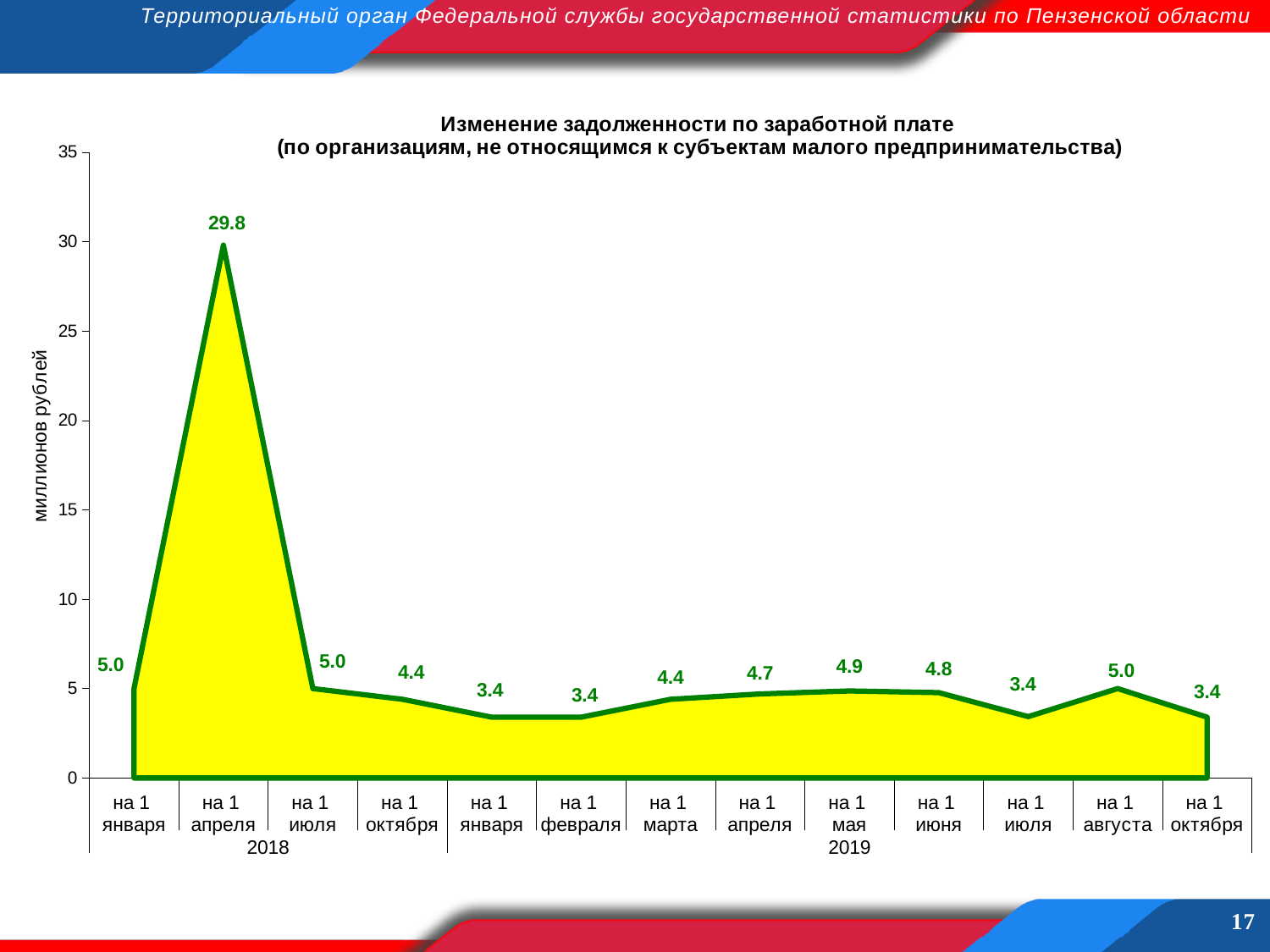
Is the value on 1 апреля 2018 greater or less than 25? greater What is the value shown for 1 октября 2019? 3.4 What is the value shown for 1 мая 2019? 4.9 Which is larger: the value on 1 апреля 2019 or on 1 июня 2019? на 1 июня 2019 What is the difference between the values on 1 апреля 2018 and 1 июля 2018? 24.8 What is the lowest value plotted on the chart? 3.4 Does the value rise or fall from 1 августа 2019 to 1 октября 2019? fall What is the wage arrears value on 1 апреля 2018? 29.8 What type of chart is shown on the slide? area chart At which date is the wage arrears value highest? на 1 апреля 2018 How many data points are plotted on the chart? 13 What unit is shown on the vertical axis label? миллионов рублей